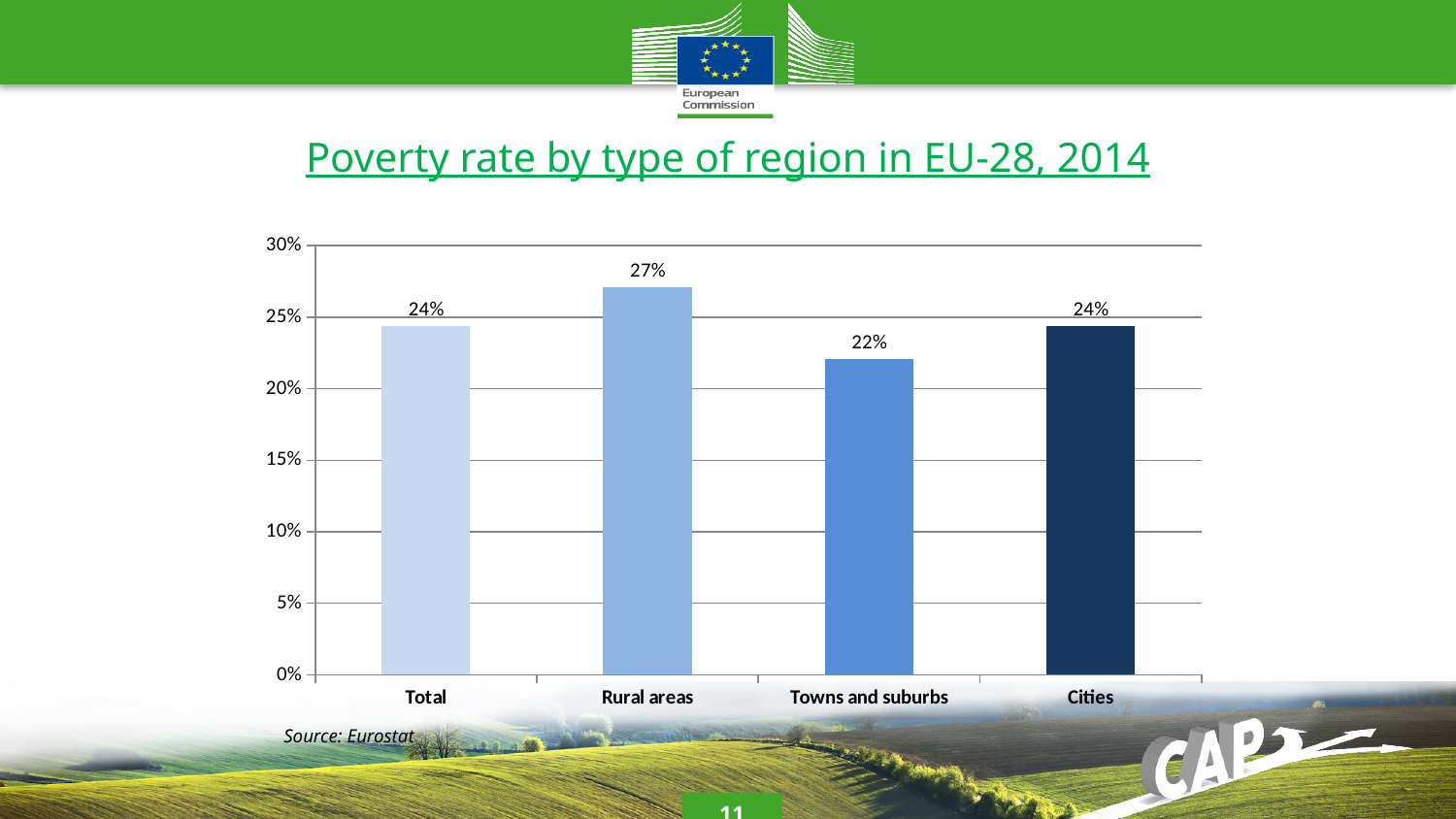
What kind of chart is shown on the slide? Bar chart Which type of region has the lowest poverty rate? Towns and suburbs What is the poverty rate for Total? 24% How many types of region are shown on the chart? 4 Which has a higher poverty rate, Rural areas or Cities? Rural areas Which type of region has the highest poverty rate? Rural areas What is the poverty rate for Cities? 24% What is the difference in poverty rate between Rural areas and Towns and suburbs? 5% What is the title of the chart? Poverty rate by type of region in EU-28, 2014 What is the poverty rate for Towns and suburbs? 22% What is the poverty rate for Rural areas? 27% What is the difference in poverty rate between Rural areas and Cities? 3%